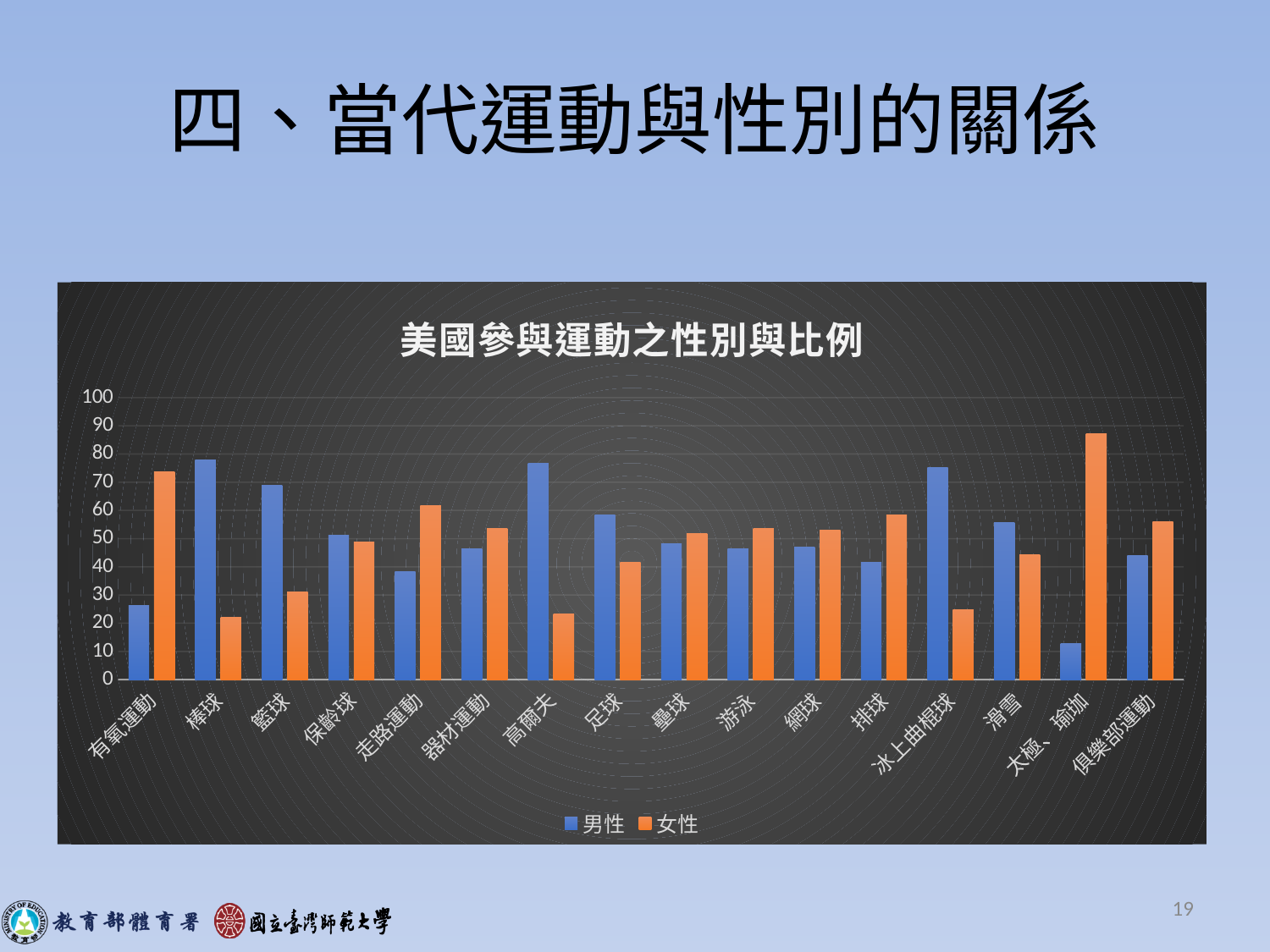
What kind of chart is shown on the slide? bar chart Is the 女性 value for 太極、瑜珈 greater or less than 80? greater For 有氧運動, which series has the larger value, 男性 or 女性? 女性 Which category has the highest 女性 value? 太極、瑜珈 What are the two series named in the legend? 男性 and 女性 How many series does the legend list? 2 Is the 男性 value for 太極、瑜珈 greater or less than 20? less For 冰上曲棍球, which series has the larger value, 男性 or 女性? 男性 How many sport categories are shown on the x axis? 16 What is the title of the chart? 美國參與運動之性別與比例 Which category has the lowest 男性 value? 太極、瑜珈 Is the 女性 value for 高爾夫 greater or less than 30? less